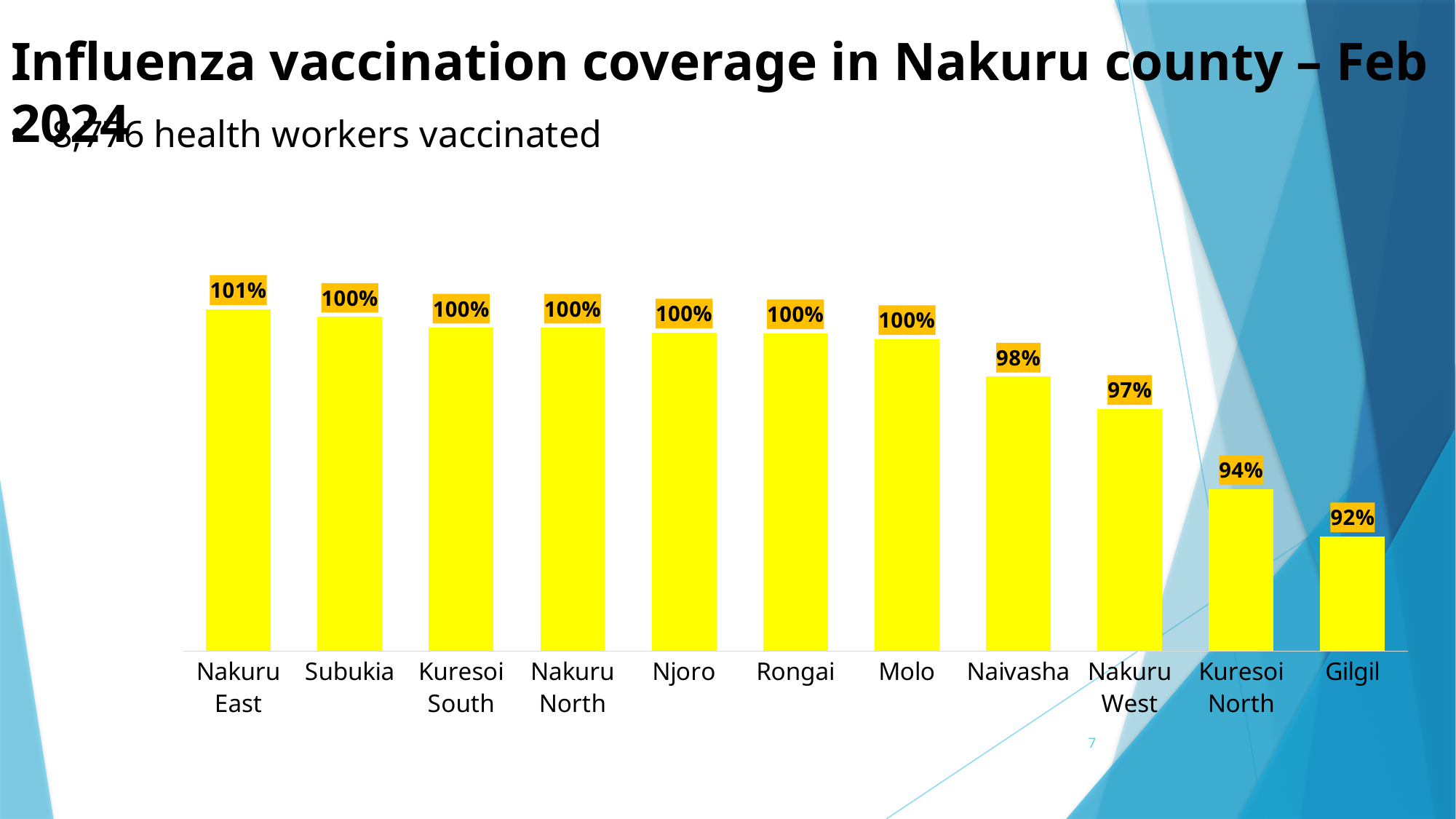
What is the vaccination coverage for Gilgil? 92% What kind of chart is shown on the slide? Bar chart What colour are the bars in the chart? Yellow What is the vaccination coverage for Kuresoi North? 94% Which sub-county has the highest vaccination coverage? Nakuru East What is the vaccination coverage for Nakuru East? 101% Do the values rise or fall from left to right along the x axis? Fall What is the vaccination coverage for Naivasha? 98% How many sub-counties are shown in the chart? 11 Which sub-county has the lowest vaccination coverage? Gilgil Which has higher coverage, Naivasha or Kuresoi North? Naivasha What is the difference in coverage between Nakuru West and Gilgil? 5%